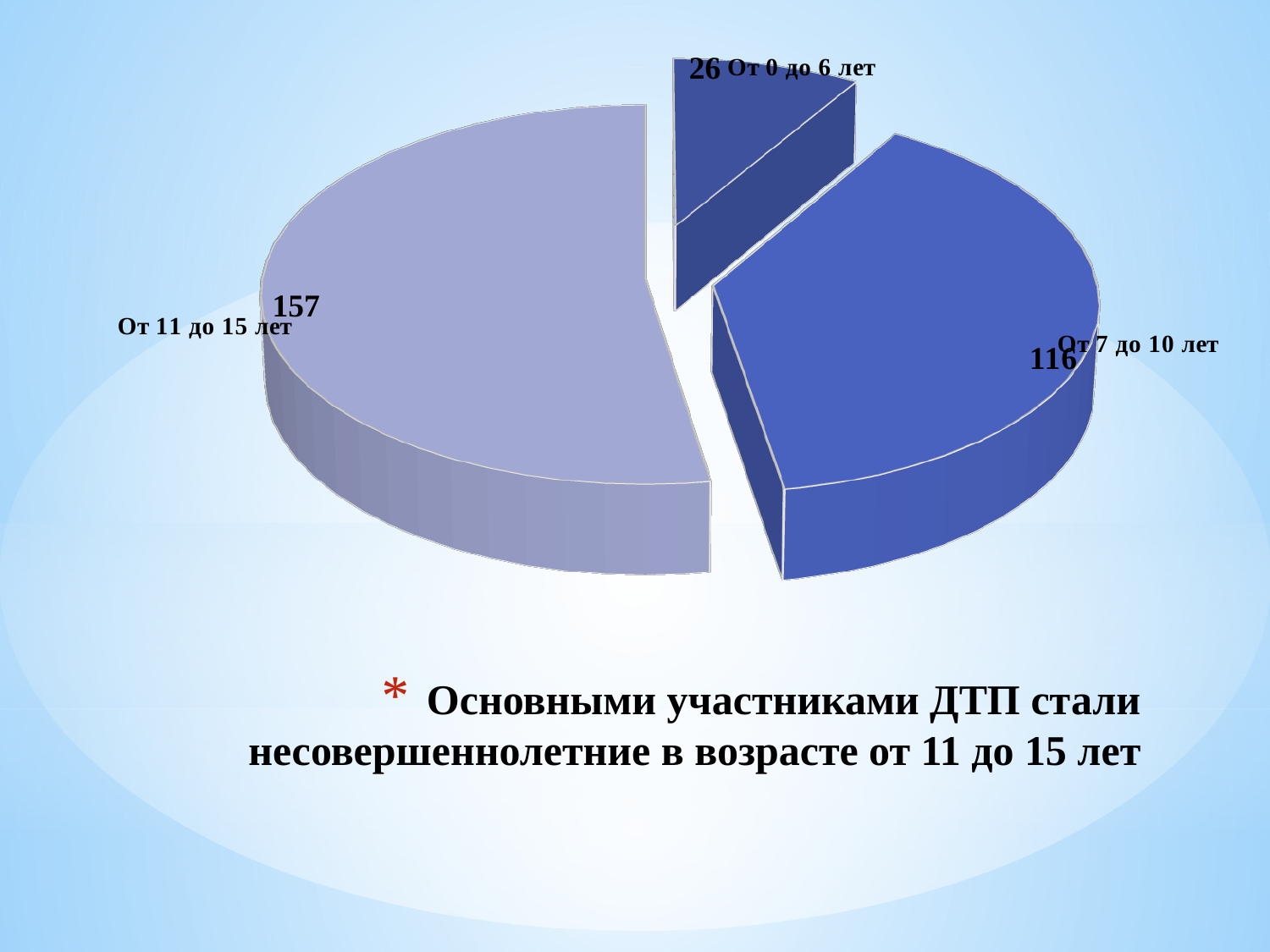
What kind of chart is shown on the slide? Pie chart How many slices does the pie chart have? 3 Which age group has the largest slice of the pie? От 11 до 15 лет Which is larger, the value for "От 7 до 10 лет" or the value for "От 0 до 6 лет"? От 7 до 10 лет Which slice of the pie is drawn in the lightest colour? От 11 до 15 лет What value is shown for the slice "От 11 до 15 лет"? 157 What is the difference between the values for "От 7 до 10 лет" and "От 0 до 6 лет"? 90 What is the difference between the values for "От 11 до 15 лет" and "От 7 до 10 лет"? 41 What value is shown for the slice "От 7 до 10 лет"? 116 What value is shown for the slice "От 0 до 6 лет"? 26 Which age group has the smallest slice of the pie? От 0 до 6 лет What is the total of all three slices in the pie chart? 299